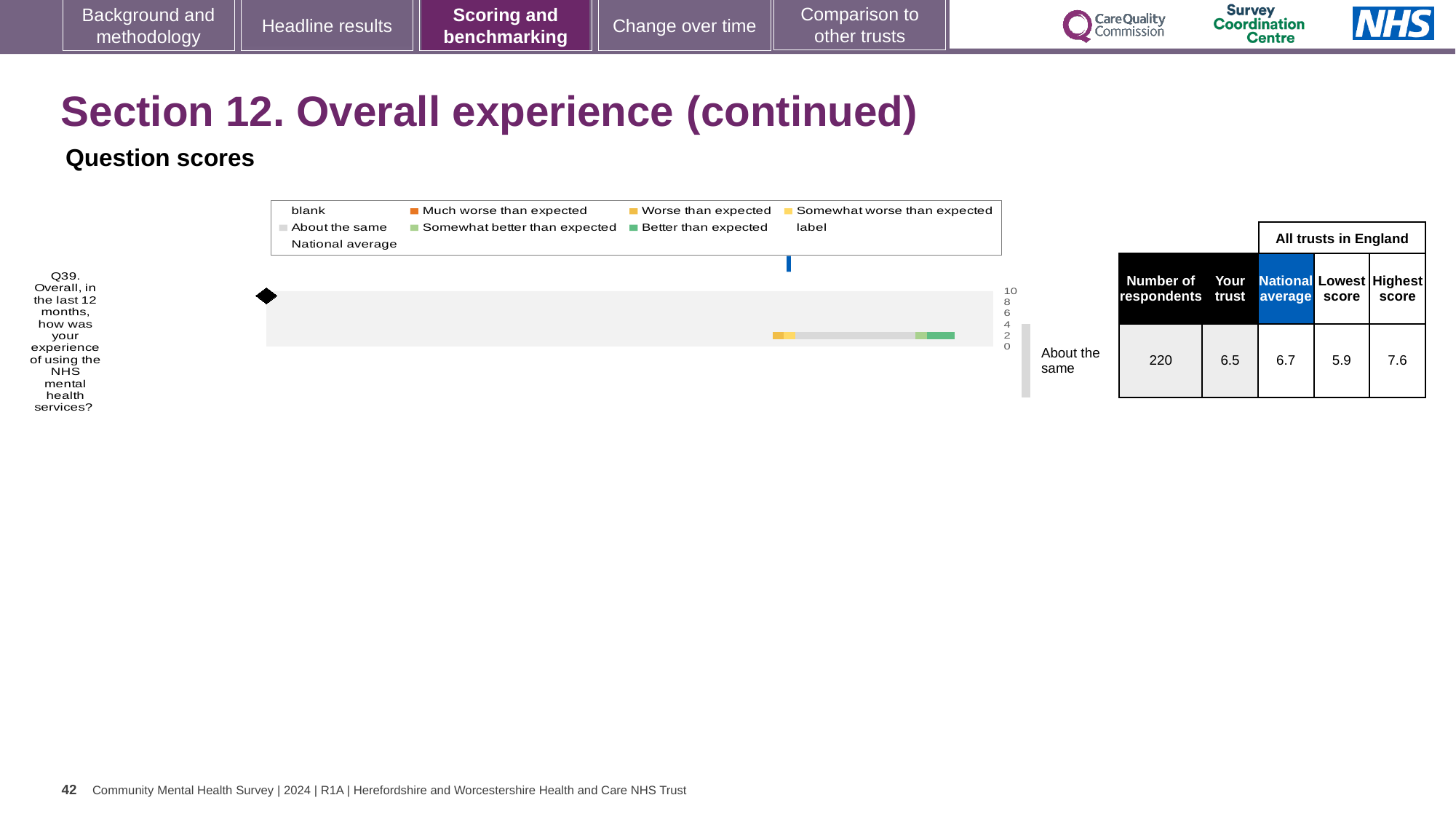
What is the 'Your trust' score shown for Q39? 6.5 What is the difference between the national average and the 'Your trust' score for Q39? 0.2 What is the lowest score among all trusts in England for Q39? 5.9 What kind of chart is used to show the Q39 benchmarking result on this slide? bar chart What is the highest score among all trusts in England for Q39? 7.6 Which benchmark category is shown next to the Q39 bar? About the same What colour does the legend use for 'Better than expected'? Green How many survey questions are plotted in the chart on this slide? 1 What is the difference between the highest score and the lowest score for Q39? 1.7 What is the number of respondents shown for Q39? 220 What is the national average score shown for Q39? 6.7 Which is larger for Q39, the 'Your trust' score or the national average? National average